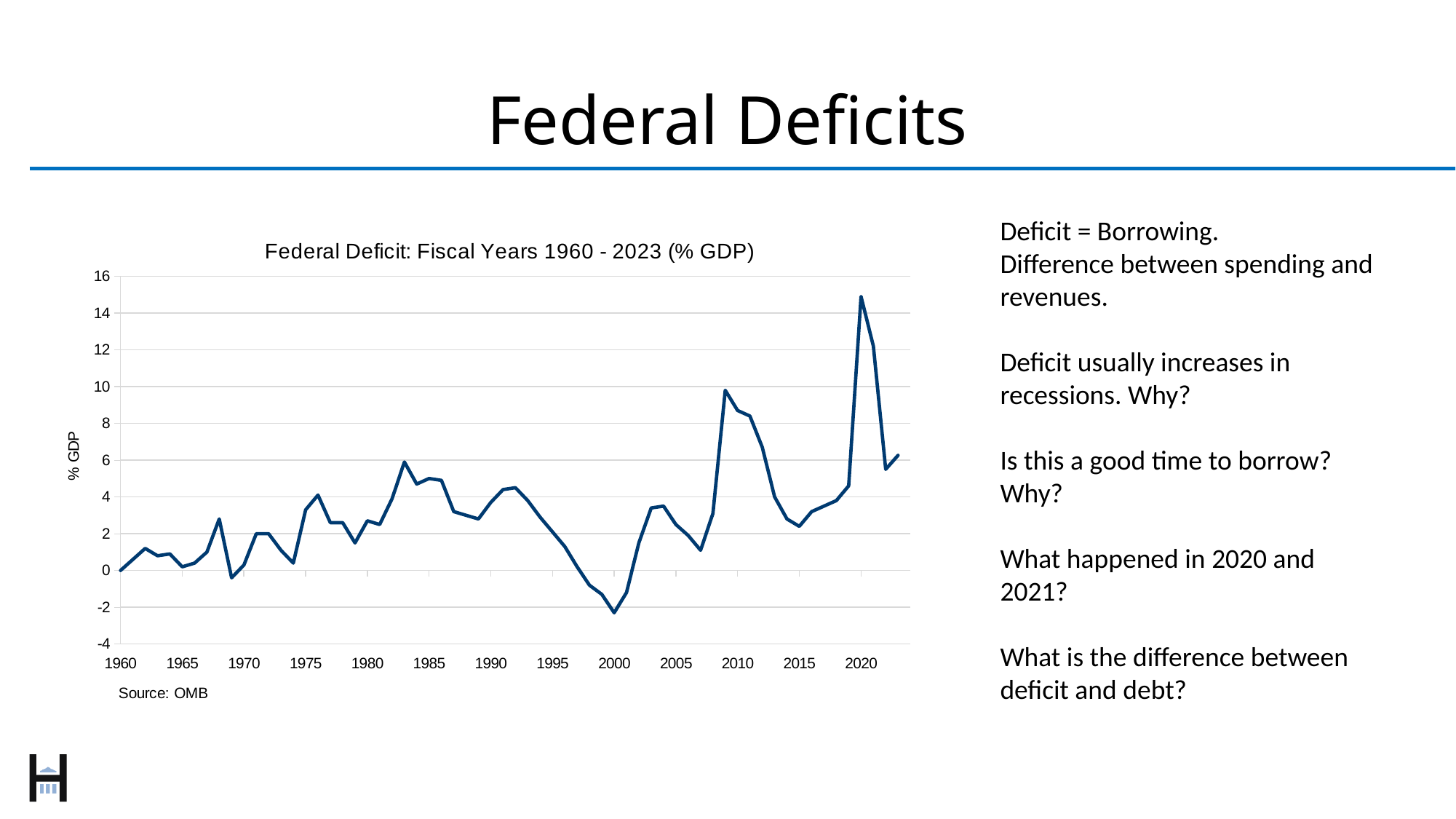
Which year has the larger deficit, 2021 or 2015? 2021 What kind of chart is shown on the slide? line chart Is the value for 1970 greater or less than 2? less Is the value for 2009 greater or less than 8? greater In which year does the federal deficit reach its lowest value on the chart? 2000 In which year does the federal deficit reach its highest value on the chart? 2020 What is the label on the vertical axis of the chart? % GDP Between 1995 and 2000, does the deficit rise or fall? fall Which year has the larger deficit, 2009 or 1983? 2009 Is the value for 2000 greater or less than 0? less What is the title of the chart? Federal Deficit: Fiscal Years 1960 - 2023 (% GDP)